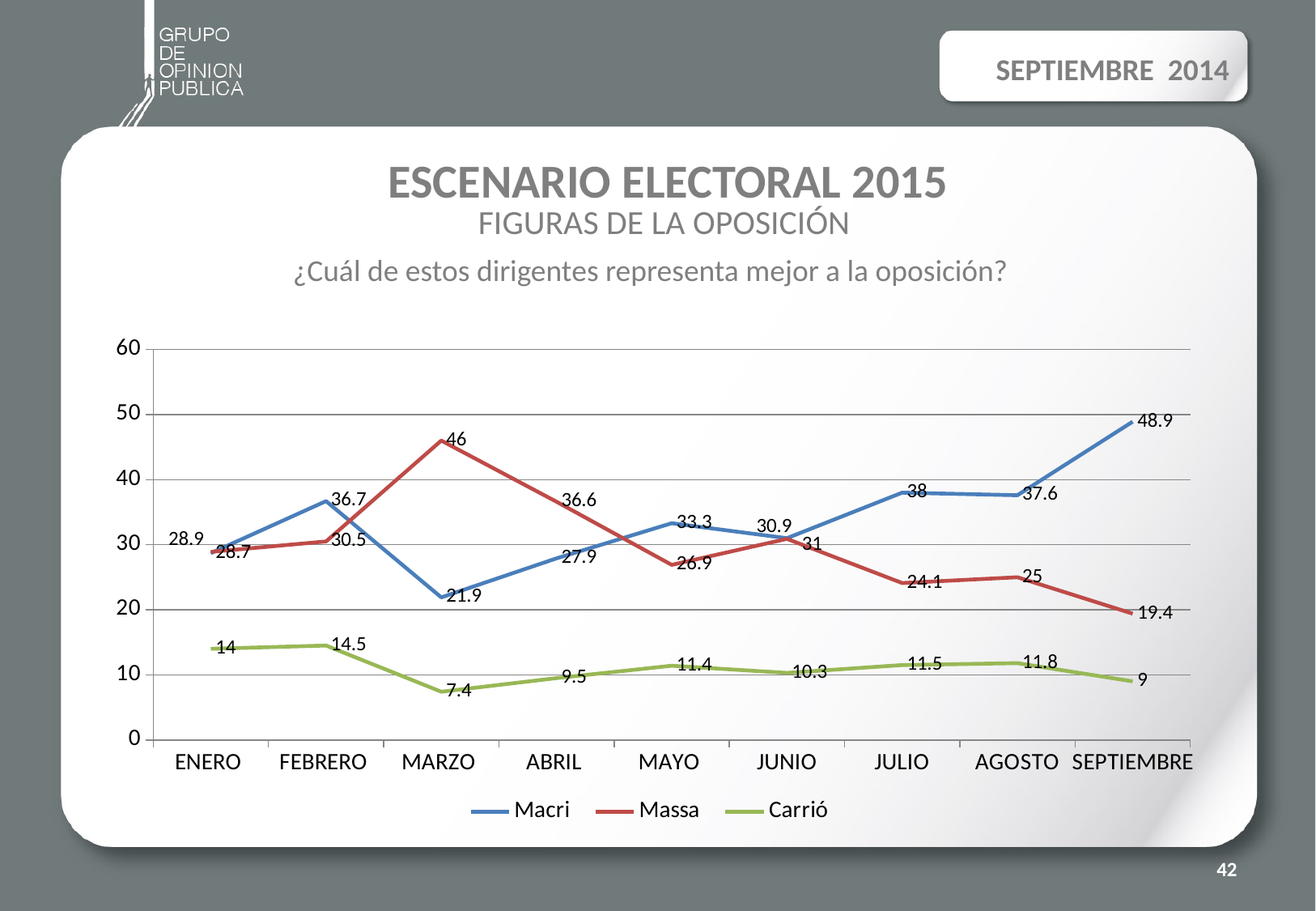
How many series does the legend list? 3 How many months are plotted along the x axis? 9 What is the value for Macri in SEPTIEMBRE? 48.9 In which month does Carrió have its lowest value? MARZO What is the value for Carrió in MARZO? 7.4 What colour is the line for Carrió? green What is the difference between Macri and Massa in SEPTIEMBRE? 29.5 What kind of chart is shown on the slide? line chart In which month does Massa reach its highest value? MARZO Does the value for Massa rise or fall from MARZO to MAYO? fall In ABRIL, which is higher, Macri or Massa? Massa What is the value for Massa in MARZO? 46